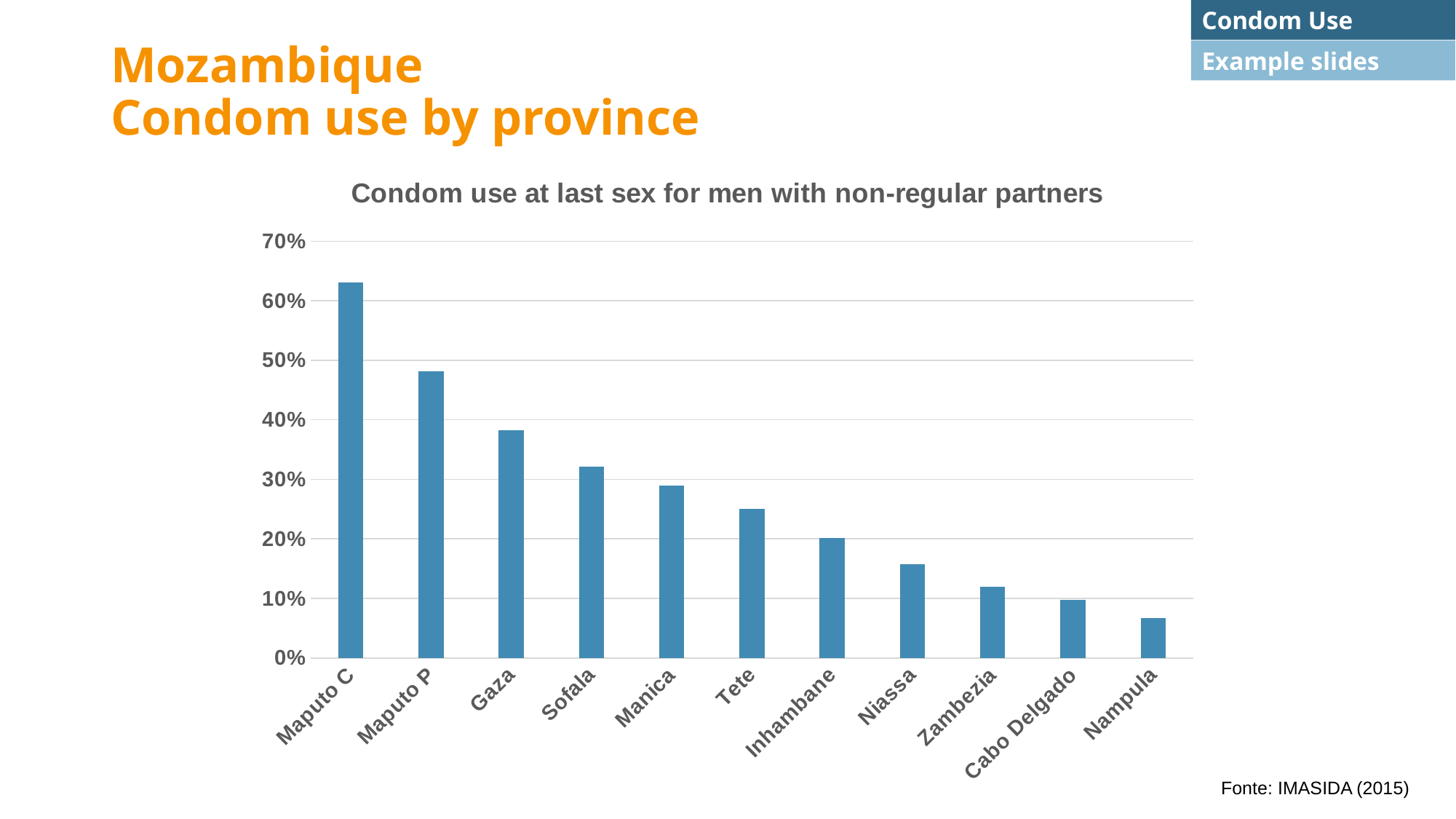
Is the value for Maputo P greater or less than 50%? less How many provinces are shown on the x axis of the chart? 11 Is the value for Gaza greater or less than 40%? less Is the value for Nampula greater or less than 10%? less What type of chart is shown on the slide? Bar chart Which province has a higher value, Gaza or Sofala? Gaza Which province has the highest condom use at last sex for men with non-regular partners? Maputo C What is the title of the chart? Condom use at last sex for men with non-regular partners Do the values rise or fall moving from left to right along the x axis? Fall Which province has the lowest condom use at last sex for men with non-regular partners? Nampula